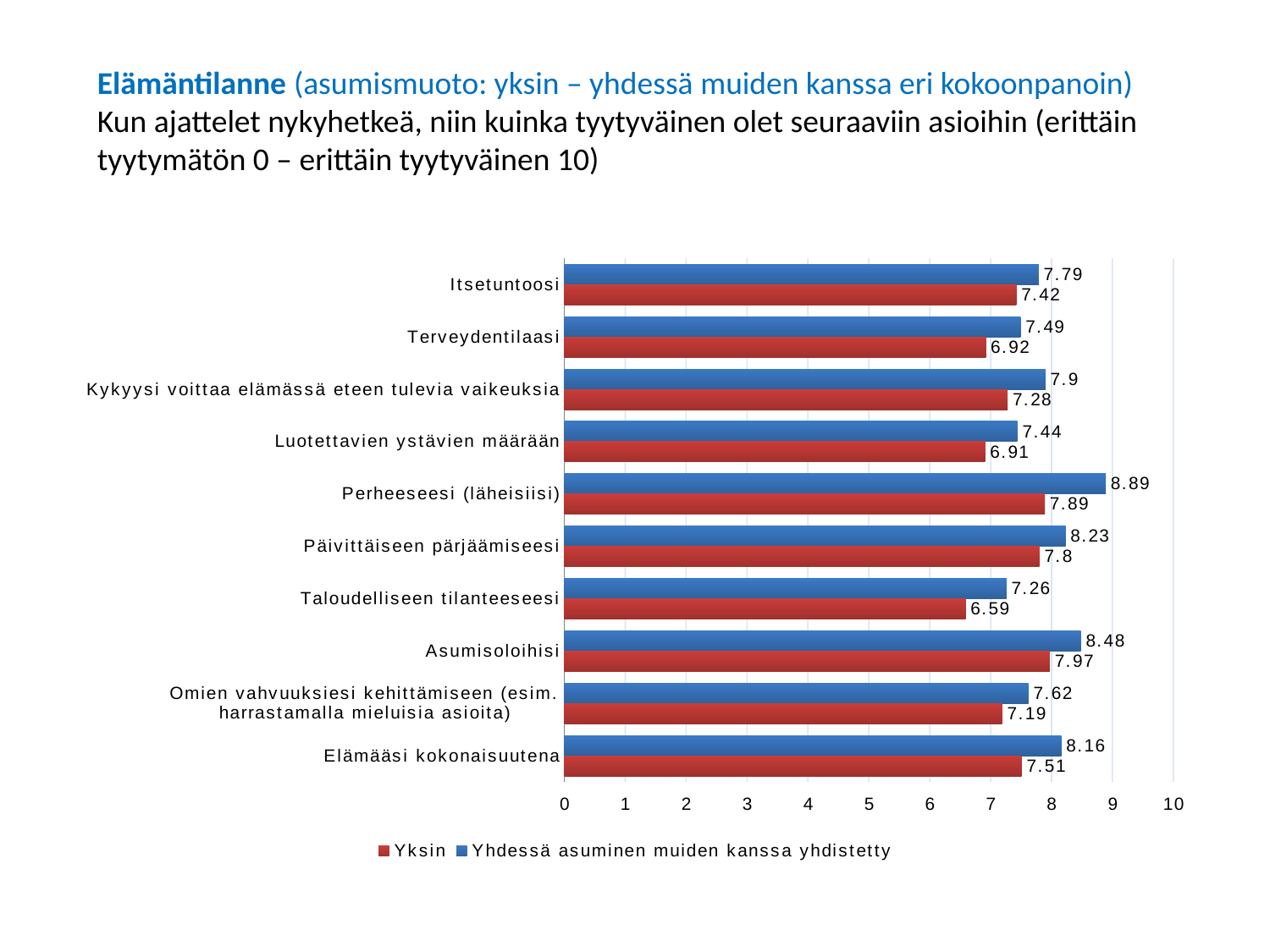
What type of chart is shown on the slide? bar chart What is the difference between the Yhdessä asuminen muiden kanssa yhdistetty and Yksin values for Taloudelliseen tilanteeseesi? 0.67 What is the value for Yhdessä asuminen muiden kanssa yhdistetty for Perheeseesi (läheisiisi)? 8.89 Which category has the lowest value for Yksin? Taloudelliseen tilanteeseesi For Elämääsi kokonaisuutena, which series has the larger value: Yksin or Yhdessä asuminen muiden kanssa yhdistetty? Yhdessä asuminen muiden kanssa yhdistetty Which series is shown in red in the legend? Yksin What is the value for Yksin for Terveydentilaasi? 6.92 How many series does the legend list? 2 Which category has the highest value for Yhdessä asuminen muiden kanssa yhdistetty? Perheeseesi (läheisiisi) What is the value for Yksin for Asumisoloihisi? 7.97 Which category has the highest value for Yksin? Asumisoloihisi How many categories are shown on the chart? 10